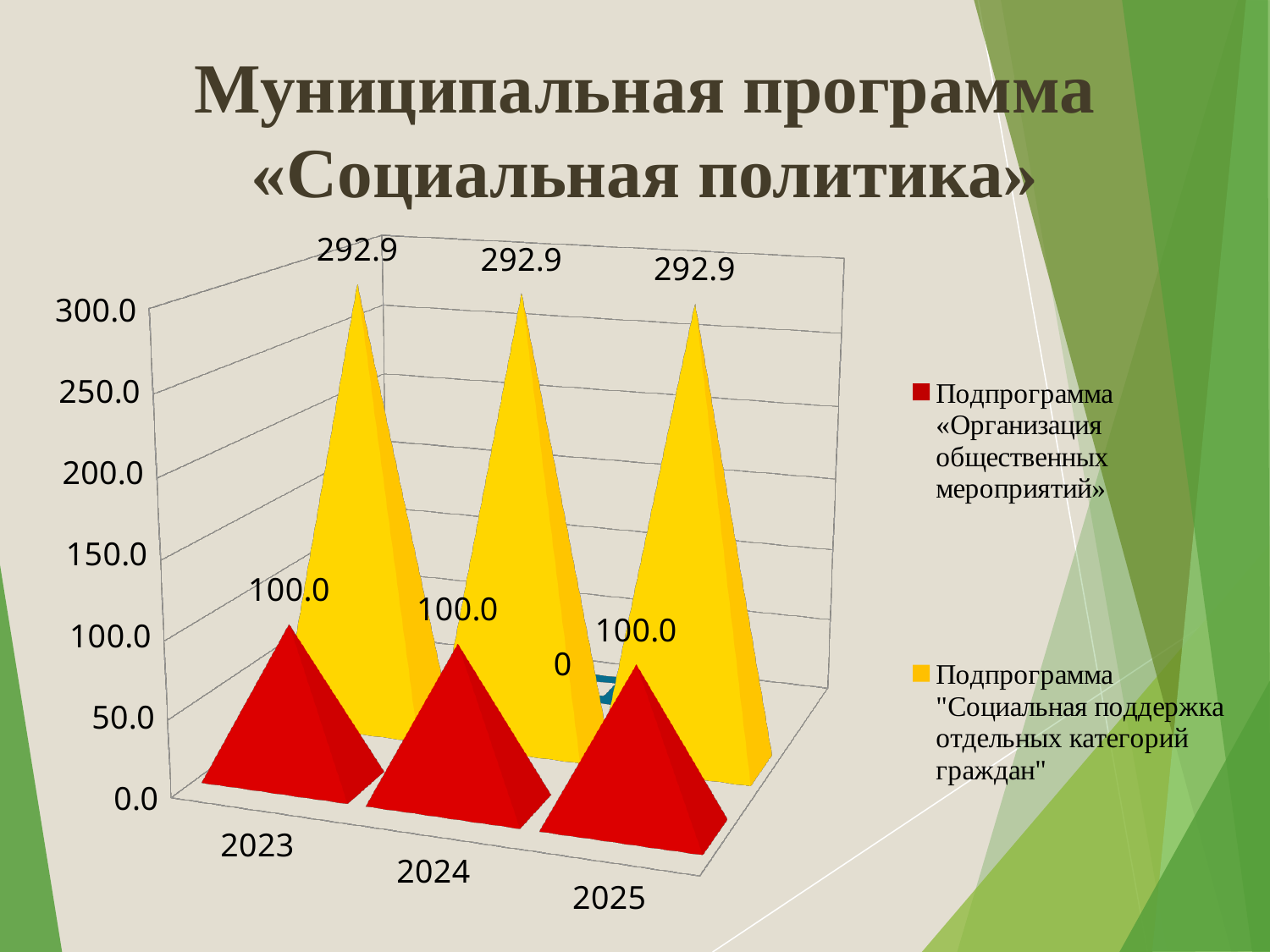
Is the value for the red series in 2024 greater or less than 150.0? less How many series does the legend list? 2 What is the value for the red series «Организация общественных мероприятий» in 2025? 100.0 What kind of chart is shown on the slide? Bar chart How many years are shown on the x axis? 3 Which series has the larger value in 2023, «Организация общественных мероприятий» or "Социальная поддержка отдельных категорий граждан"? "Социальная поддержка отдельных категорий граждан" What colour represents the series "Социальная поддержка отдельных категорий граждан"? Yellow What is the value for the red series «Организация общественных мероприятий» in 2023? 100.0 What is the value for the yellow series "Социальная поддержка отдельных категорий граждан" in 2024? 292.9 What is the value for the yellow series "Социальная поддержка отдельных категорий граждан" in 2025? 292.9 What is the difference between the yellow and red series values in 2024? 192.9 Does the value of the yellow series rise, fall, or stay the same from 2023 to 2025? Stays the same